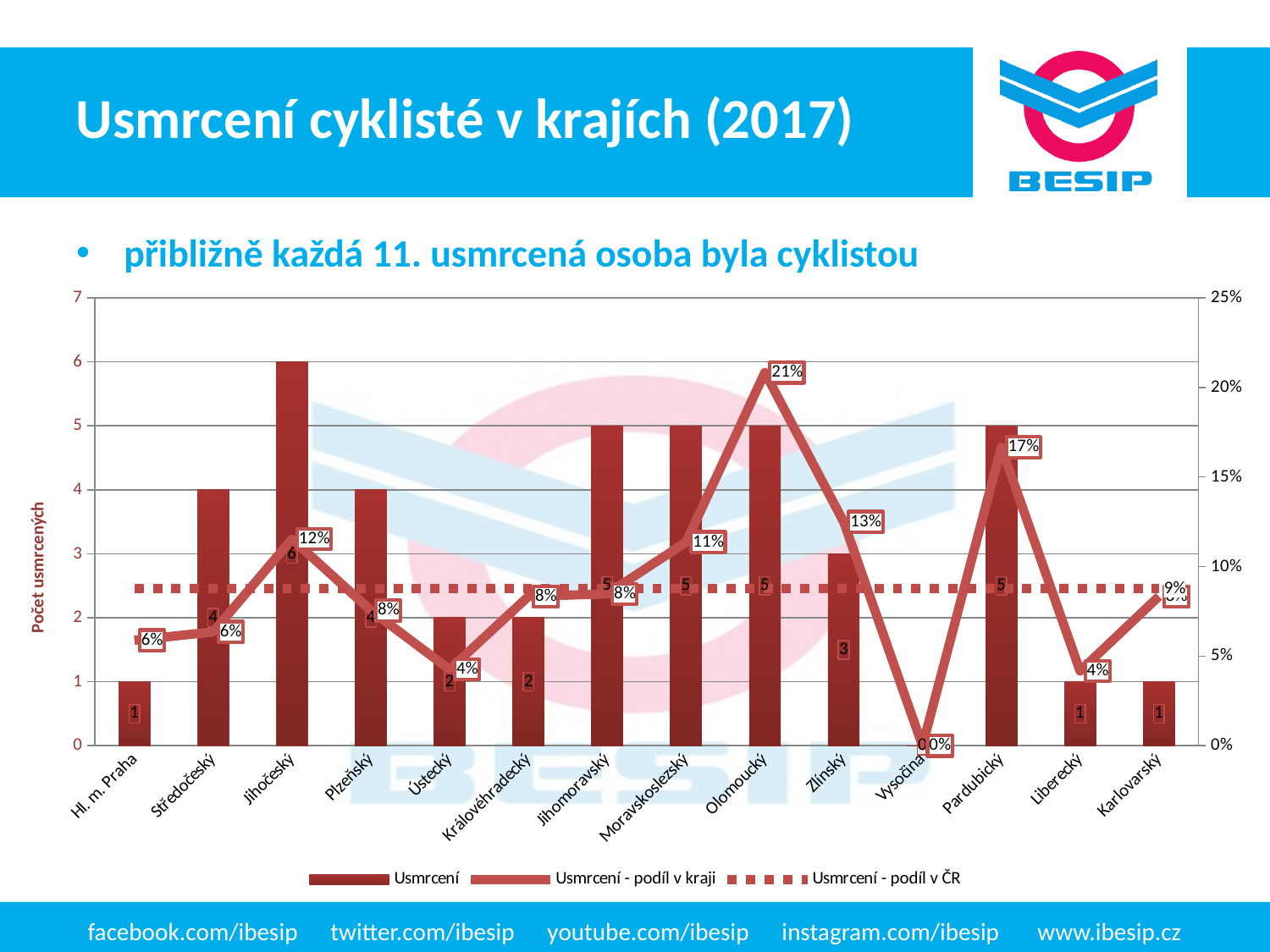
What is the 'Usmrcení - podíl v kraji' value for Olomoucký? 21% How many regions are shown on the x axis? 14 How many series does the legend list? 3 What is the difference in killed cyclists (Usmrcení) between Jihočeský and Hl. m. Praha? 5 Which region has the highest value for 'Usmrcení - podíl v kraji'? Olomoucký How many killed cyclists (Usmrcení) are shown for Jihočeský? 6 Which region has the highest number of killed cyclists (Usmrcení)? Jihočeský What is the title of the chart slide? Usmrcení cyklisté v krajích (2017) Which region has more killed cyclists (Usmrcení), Středočeský or Ústecký? Středočeský What kind of chart is used to show the 'Usmrcení' series? bar chart Which region has the lowest value for 'Usmrcení - podíl v kraji'? Vysočina What is the 'Usmrcení - podíl v kraji' value for Pardubický? 17%